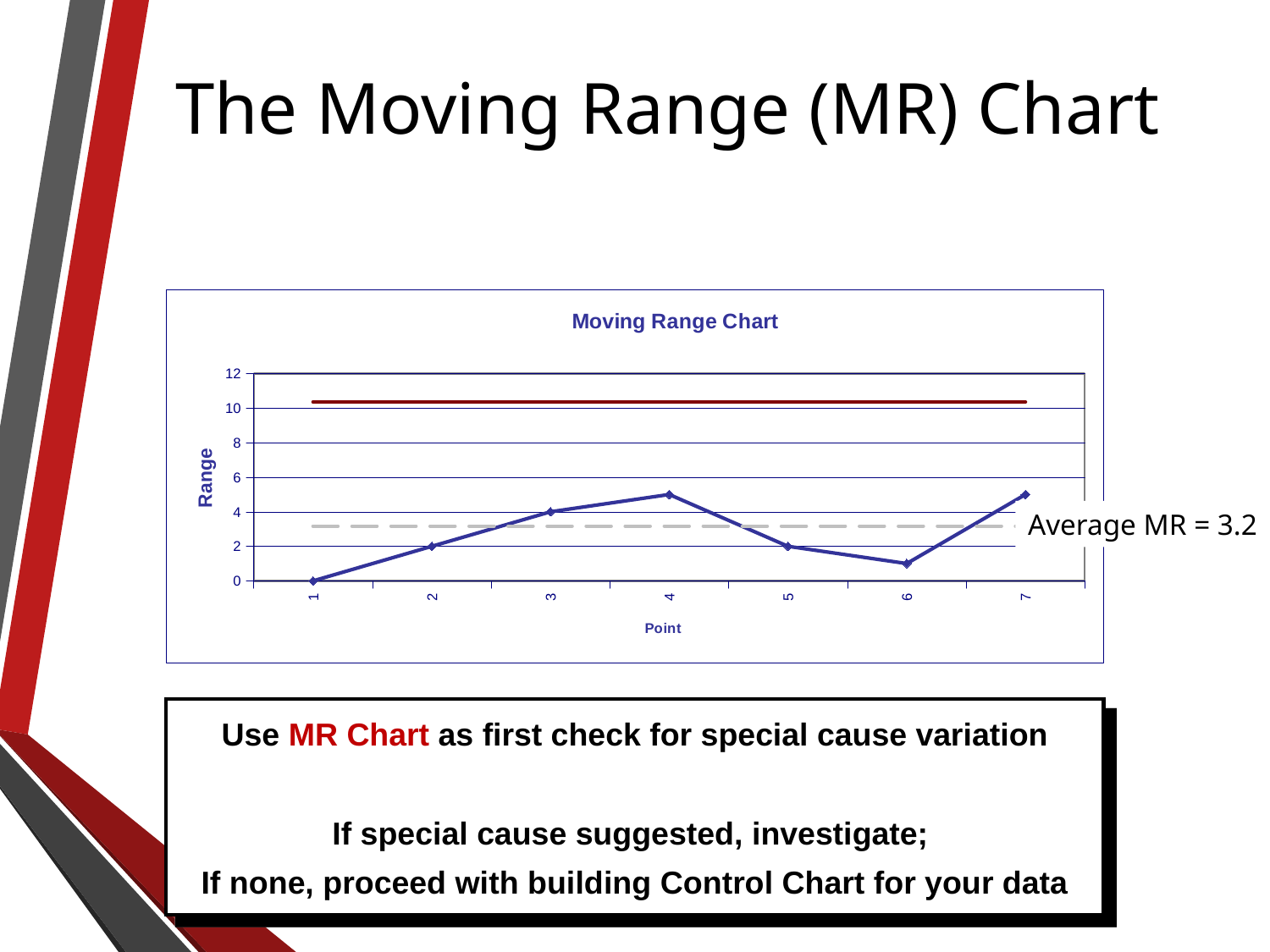
What is the difference between the range values at point 3 and point 2? 2 What is the range value at point 2 on the Moving Range Chart? 2 How many points are plotted on the Moving Range Chart? 7 Do the range values rise or fall from point 1 to point 4? rise Is the range value at point 4 greater or less than 4? greater What is the range value at point 1 on the Moving Range Chart? 0 What kind of chart is the Moving Range Chart? line chart Is the range value at point 6 greater or less than 2? less Which point has the lowest range value on the Moving Range Chart? 1 What is the Average MR value annotated on the chart? 3.2 What is the range value at point 3 on the Moving Range Chart? 4 Which has the larger range value, point 3 or point 5? point 3